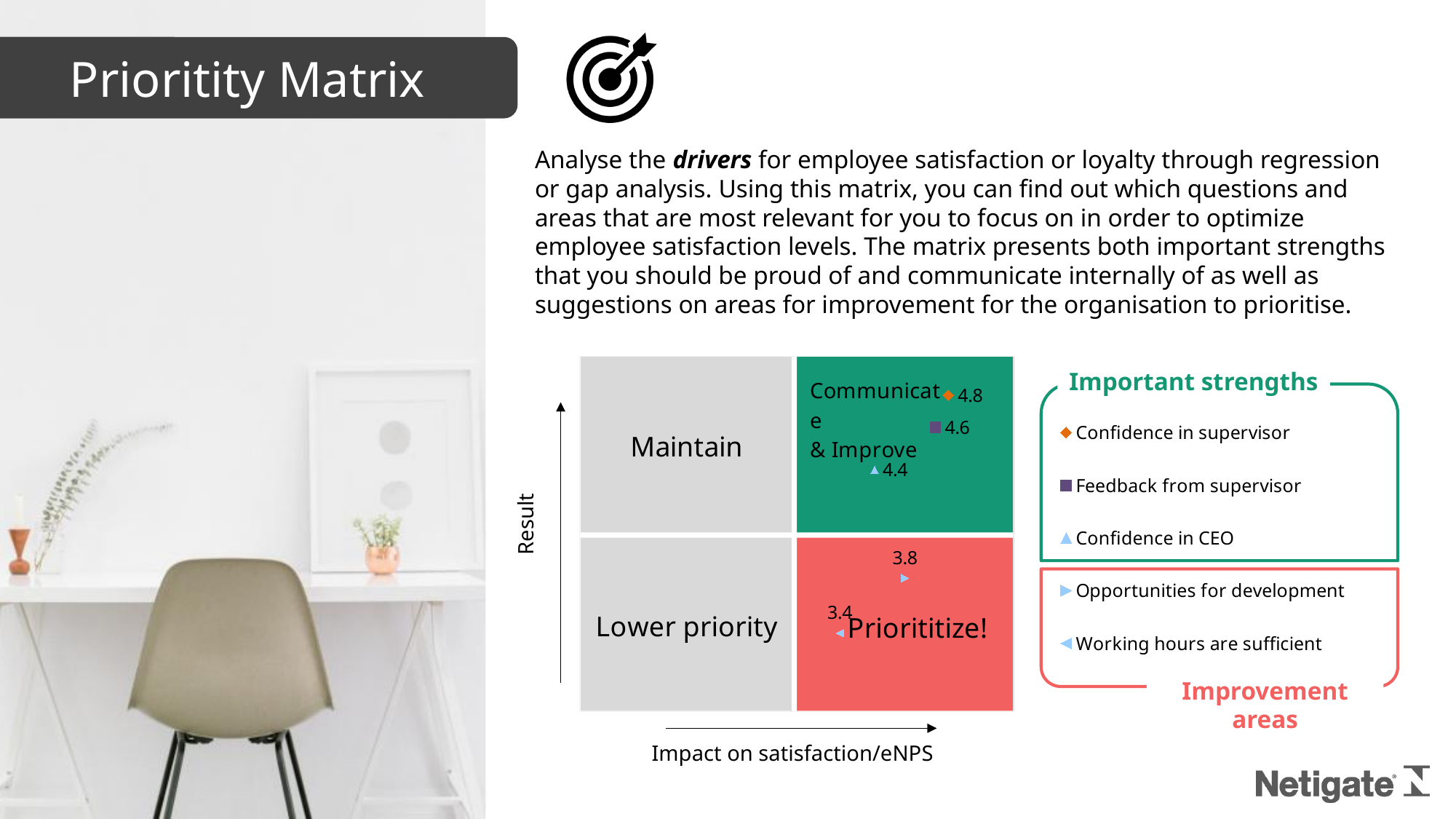
What is the difference between the values for Confidence in supervisor and Working hours are sufficient? 1.4 What is the value shown for Opportunities for development? 3.8 What is the value shown for Working hours are sufficient? 3.4 Which item has the lowest value in the matrix? Working hours are sufficient How many series does the legend list? 5 Which item has the highest value in the matrix? Confidence in supervisor Which quadrant of the matrix contains the points for Opportunities for development and Working hours are sufficient? Priorititize! What is the label of the horizontal axis? Impact on satisfaction/eNPS What is the value shown for Feedback from supervisor? 4.6 What is the value shown for Confidence in CEO? 4.4 What is the value shown for Confidence in supervisor? 4.8 Which has a higher value, Feedback from supervisor or Opportunities for development? Feedback from supervisor